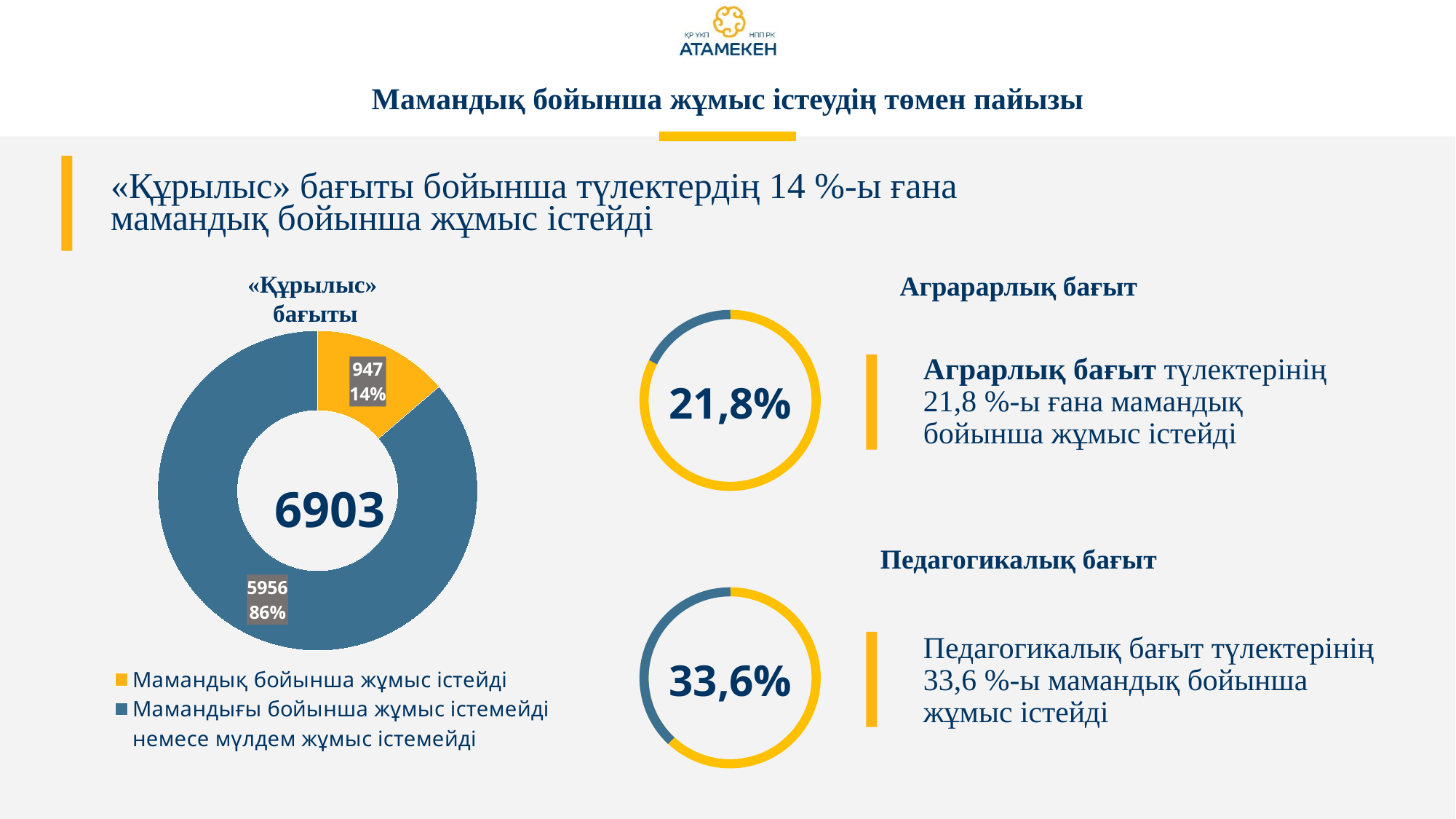
In the «Құрылыс» бағыты donut chart, what is the difference between the two slice values (5956 and 947)? 5009 How many entries does the legend of the «Құрылыс» бағыты chart list? 2 Which ring chart shows the larger percentage, Аграрарлық бағыт or Педагогикалық бағыт? Педагогикалық бағыт In the «Құрылыс» бағыты donut chart, what share of the pie does «Мамандығы бойынша жұмыс істемейді немесе мүлдем жұмыс істемейді» take? 86% What kind of chart is the «Құрылыс» бағыты chart? Pie (donut) chart In the «Құрылыс» бағыты donut chart, what value is shown for «Мамандық бойынша жұмыс істейді»? 947 In the Аграрарлық бағыт ring chart, what percentage is shown? 21,8% In the Педагогикалық бағыт ring chart, what percentage is shown? 33,6% In the «Құрылыс» бағыты donut chart, what is the total shown in the centre of the chart? 6903 In the «Құрылыс» бағыты donut chart, what percentage is shown for «Мамандық бойынша жұмыс істейді»? 14% In the «Құрылыс» бағыты chart, which slice is the largest? Мамандығы бойынша жұмыс істемейді немесе мүлдем жұмыс істемейді In the «Құрылыс» бағыты donut chart, what value is shown for «Мамандығы бойынша жұмыс істемейді немесе мүлдем жұмыс істемейді»? 5956